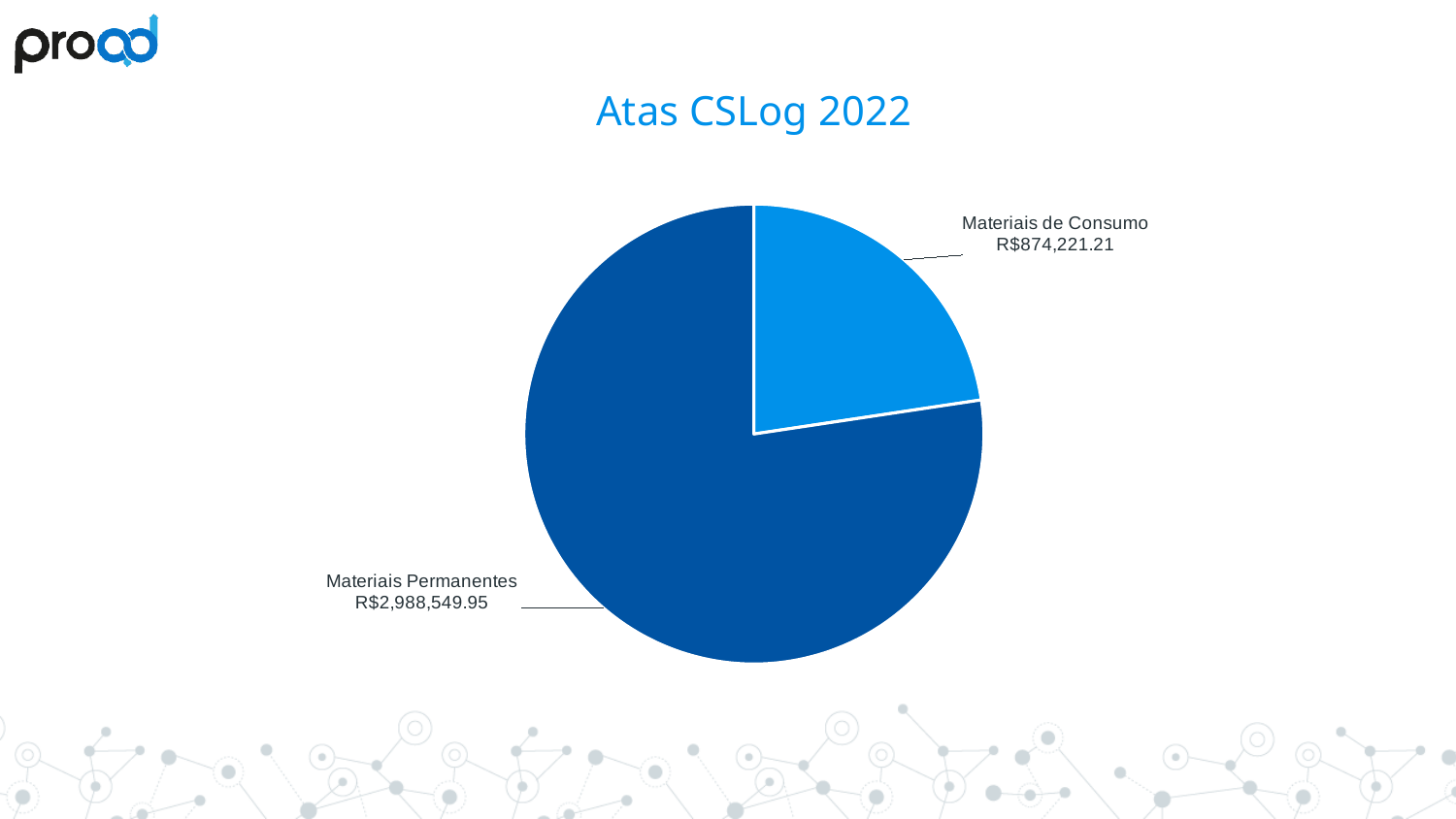
Which category has the largest slice of the pie? Materiais Permanentes What is the total of the two slices in the pie chart? R$3,862,771.16 Which is larger, Materiais de Consumo or Materiais Permanentes? Materiais Permanentes What is the difference between the values for Materiais Permanentes and Materiais de Consumo? R$2,114,328.74 What share of the pie does Materiais de Consumo represent, to one decimal place? 22.6% What type of chart is shown on the slide? Pie chart What is the value for Materiais de Consumo? R$874,221.21 What is the value for Materiais Permanentes? R$2,988,549.95 How many slices does the pie chart have? 2 Which slice is shown in the darker blue colour? Materiais Permanentes What is the title of the chart? Atas CSLog 2022 Which category has the smallest slice of the pie? Materiais de Consumo